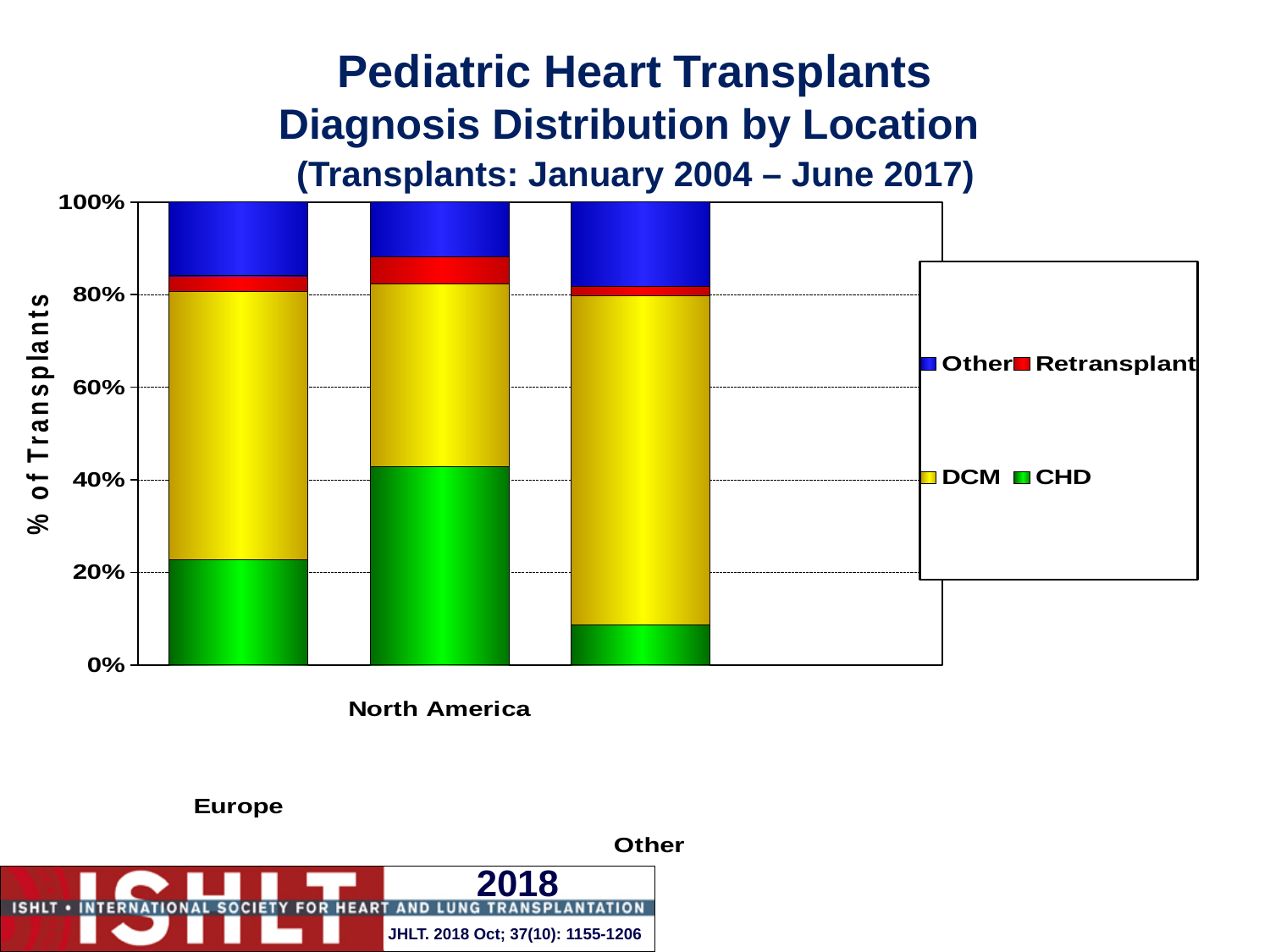
How many location categories are plotted on the x axis? 3 Is the CHD share for Europe greater or less than 40%? less Which location has the largest CHD share of transplants? North America How many series does the legend list? 4 Which location has a larger CHD segment, Europe or North America? North America What kind of chart is shown on the slide? Stacked bar chart Which location has a larger DCM segment, North America or Other? Other What is the label of the y axis? % of Transplants What colour represents DCM in the legend? Yellow Is the CHD share for the Other location greater or less than 20%? less Is the CHD share for North America greater or less than 20%? greater Which location has the smallest CHD share of transplants? Other